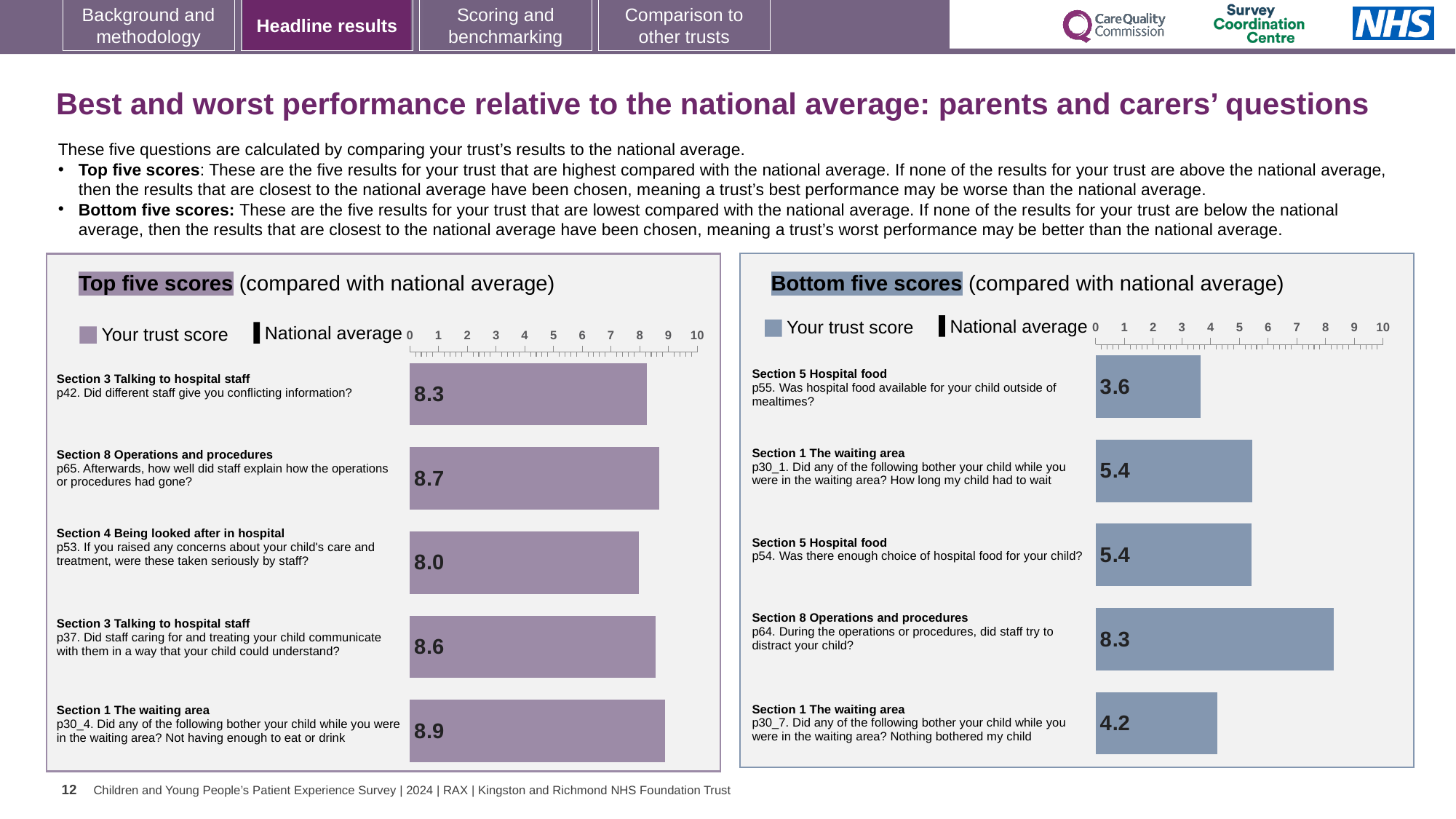
In the Bottom five scores chart, is the trust score for p30_7 (Nothing bothered my child) greater or less than 5? less In the Top five scores chart, what is the trust score for p65 (how well did staff explain how the operations or procedures had gone)? 8.7 What kind of chart is the Top five scores chart? bar chart How many questions are plotted in the Bottom five scores chart? 5 In the Top five scores chart, what is the difference between the trust scores for p30_4 and p53? 0.9 In the Bottom five scores chart, what is the trust score for p55 (was hospital food available for your child outside of mealtimes)? 3.6 In the Bottom five scores chart, which question has the highest trust score? p64 (did staff try to distract your child), 8.3 In the Bottom five scores chart, what is the difference between the trust scores for p64 and p55? 4.7 In the Top five scores chart, which question has the highest trust score? p30_4 (Not having enough to eat or drink), 8.9 In the Bottom five scores chart, which question has the lowest trust score? p55 (hospital food available outside of mealtimes), 3.6 In the Top five scores chart, which question has the lowest trust score? p53 (concerns taken seriously by staff), 8.0 In the Top five scores chart, which has the larger trust score: p42 or p37? p37 (8.6)